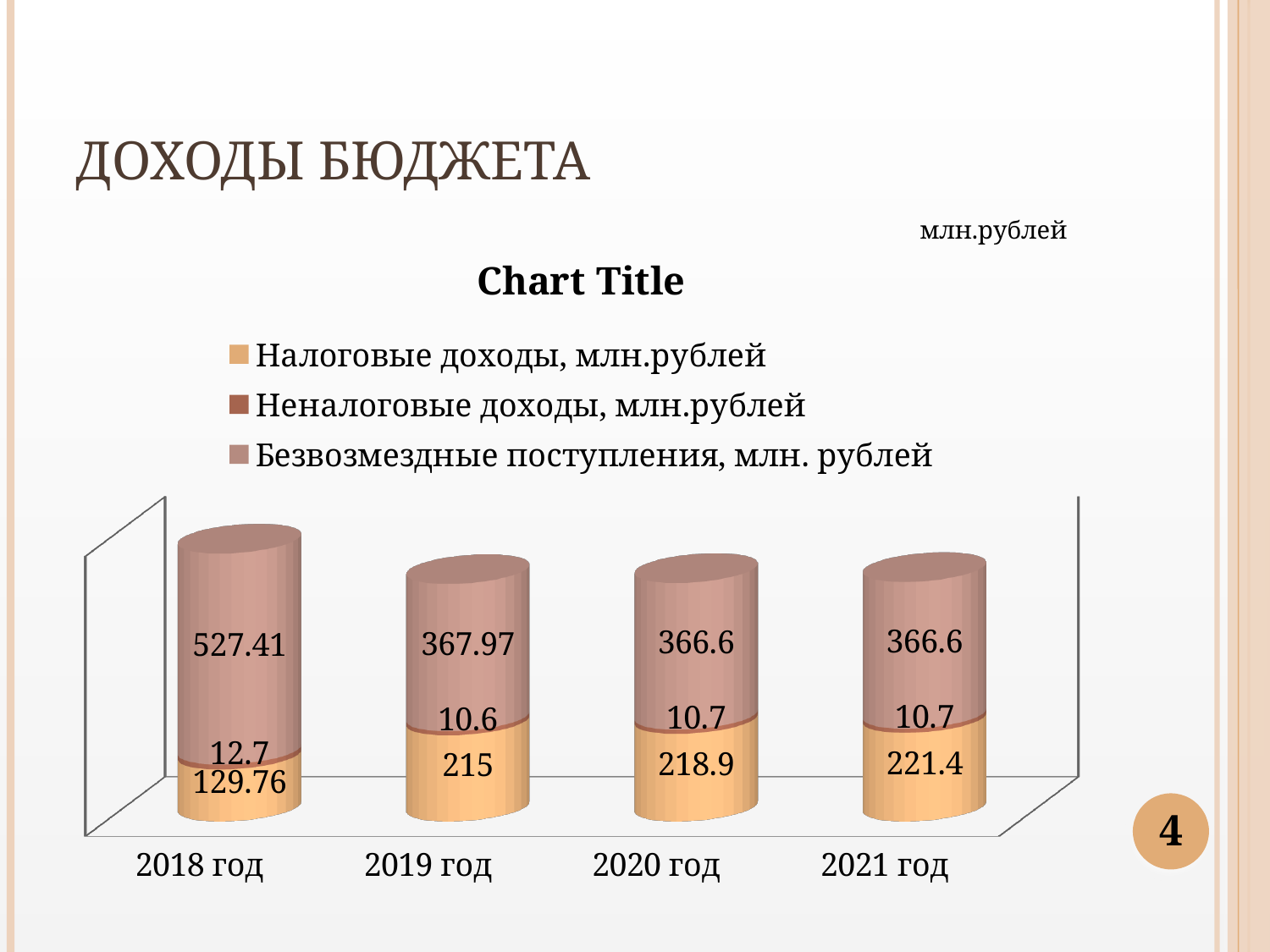
What is the difference between Налоговые доходы in 2021 год and in 2018 год? 91.64 What is the total of the stacked bar for 2019 год? 593.57 What type of chart is shown on the slide? stacked bar chart In which year is Безвозмездные поступления highest? 2018 год In which year is Налоговые доходы lowest? 2018 год Do the Налоговые доходы values rise or fall from 2018 год to 2021 год? rise What is the value of Безвозмездные поступления for 2019 год? 367.97 How many series does the legend list? 3 What is the value of Налоговые доходы for 2018 год? 129.76 How many years (categories) are shown on the x axis? 4 Which is larger: Безвозмездные поступления in 2018 год or in 2019 год? 2018 год What is the value of Неналоговые доходы for 2020 год? 10.7